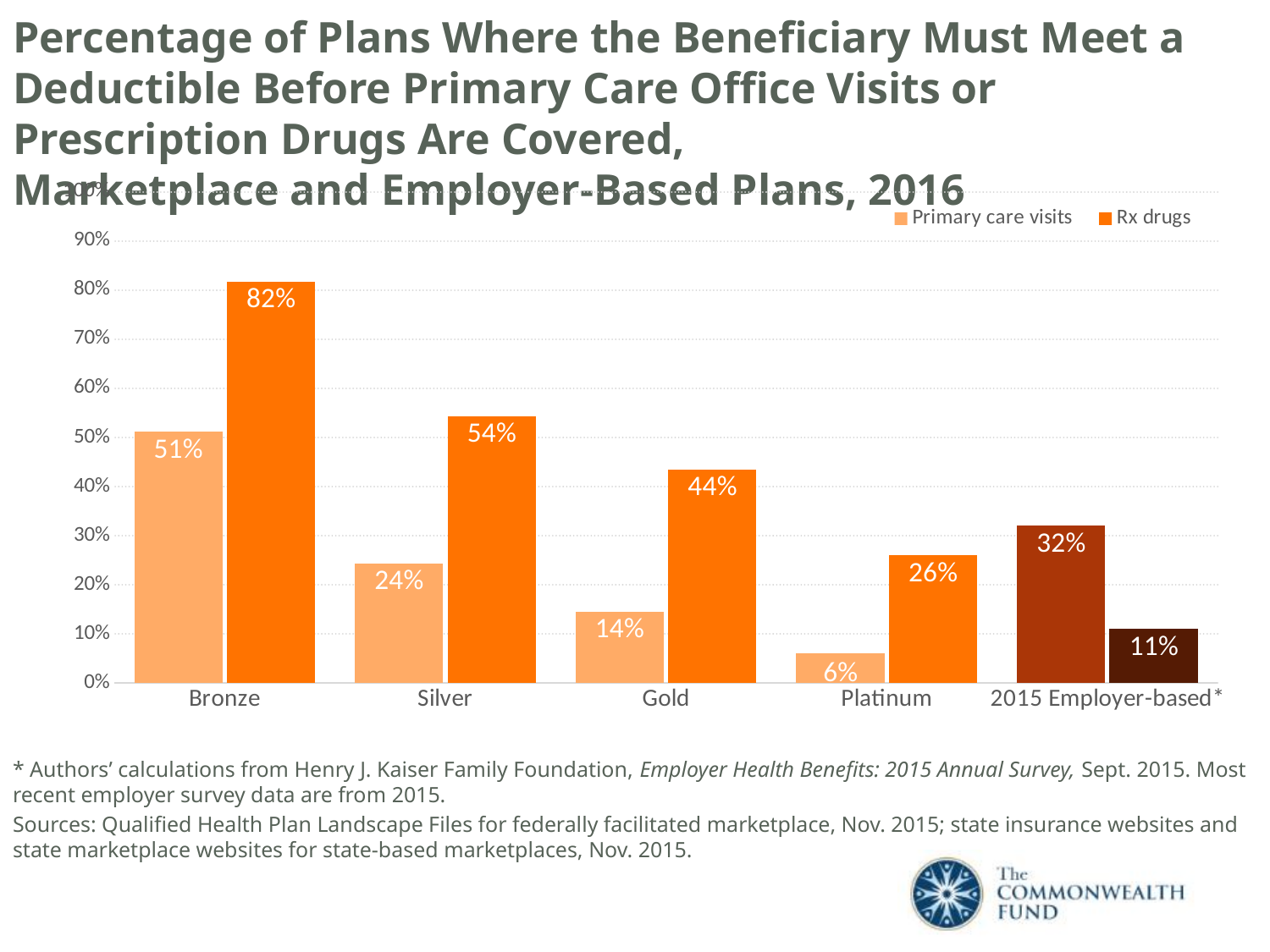
How many series does the legend list? 2 Which is larger for Platinum plans: Primary care visits or Rx drugs? Rx drugs Which plan category has the highest Rx drugs value? Bronze How many plan categories are shown on the x axis? 5 What is the difference between the Rx drugs and Primary care visits values for Gold plans? 30 percentage points What percentage of Bronze plans require meeting a deductible before Rx drugs are covered? 82% What kind of chart is shown on the slide? Bar chart What is the value for Primary care visits in Silver plans? 24% Is the Primary care visits value for Bronze plans greater or less than 50%? greater Which plan category has the lowest Primary care visits value? Platinum What is the Rx drugs value for 2015 Employer-based plans? 11% Do the Rx drugs values rise or fall from Bronze to Platinum? Fall